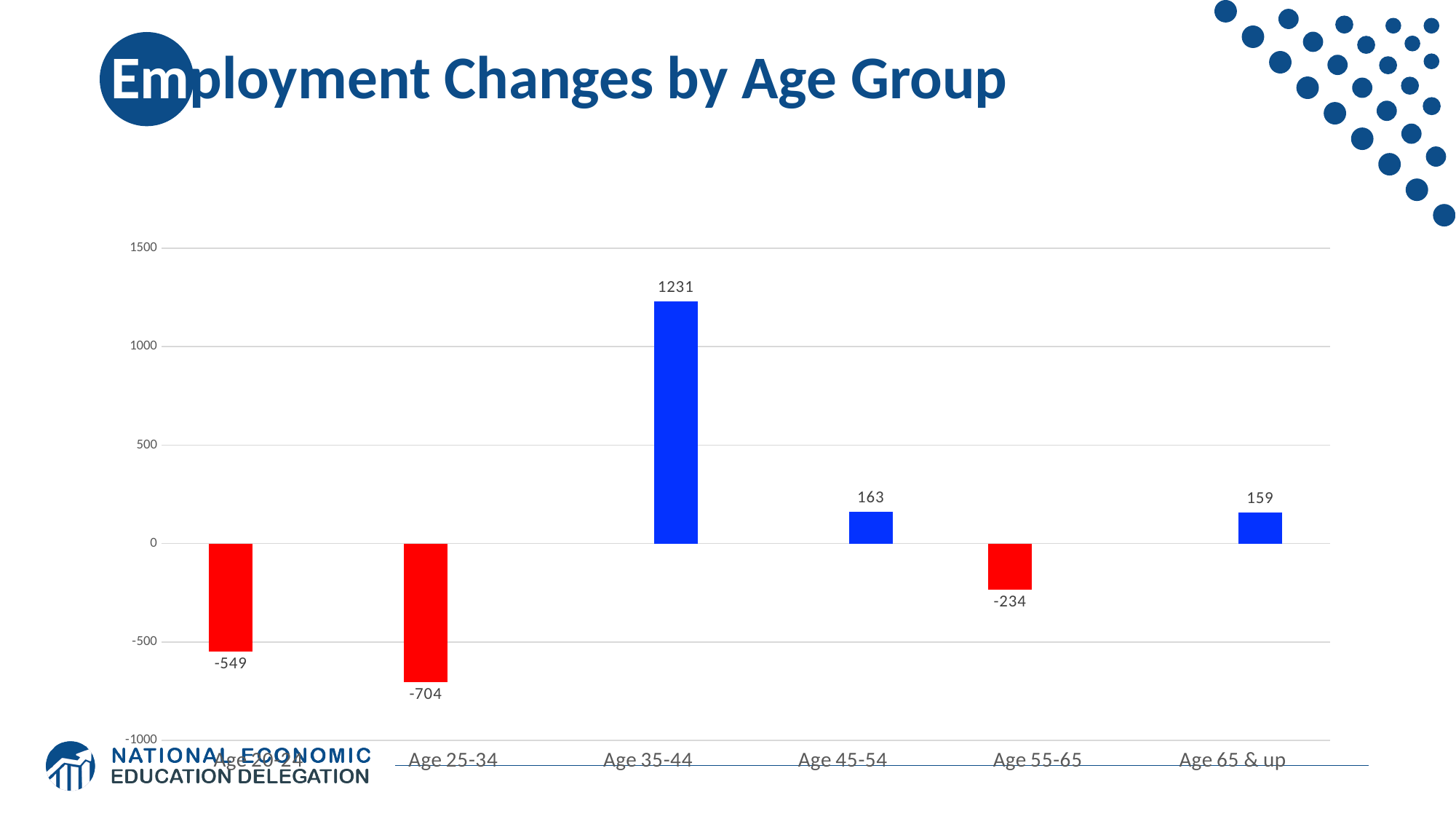
How many age groups are shown in the chart? 6 What is the employment change for Age 65 & up? 159 Which has the larger employment change, Age 45-54 or Age 65 & up? Age 45-54 What is the difference between the employment change for Age 35-44 and Age 45-54? 1068 What kind of chart is shown on the slide? bar chart Is the value for Age 35-44 greater or less than 1000? greater What is the employment change for Age 25-34? -704 What is the difference between the employment change for Age 20-24 and Age 25-34? 155 What is the employment change for Age 55-65? -234 Which age group has the highest employment change? Age 35-44 Which age group has the lowest employment change? Age 25-34 What is the employment change for Age 35-44? 1231